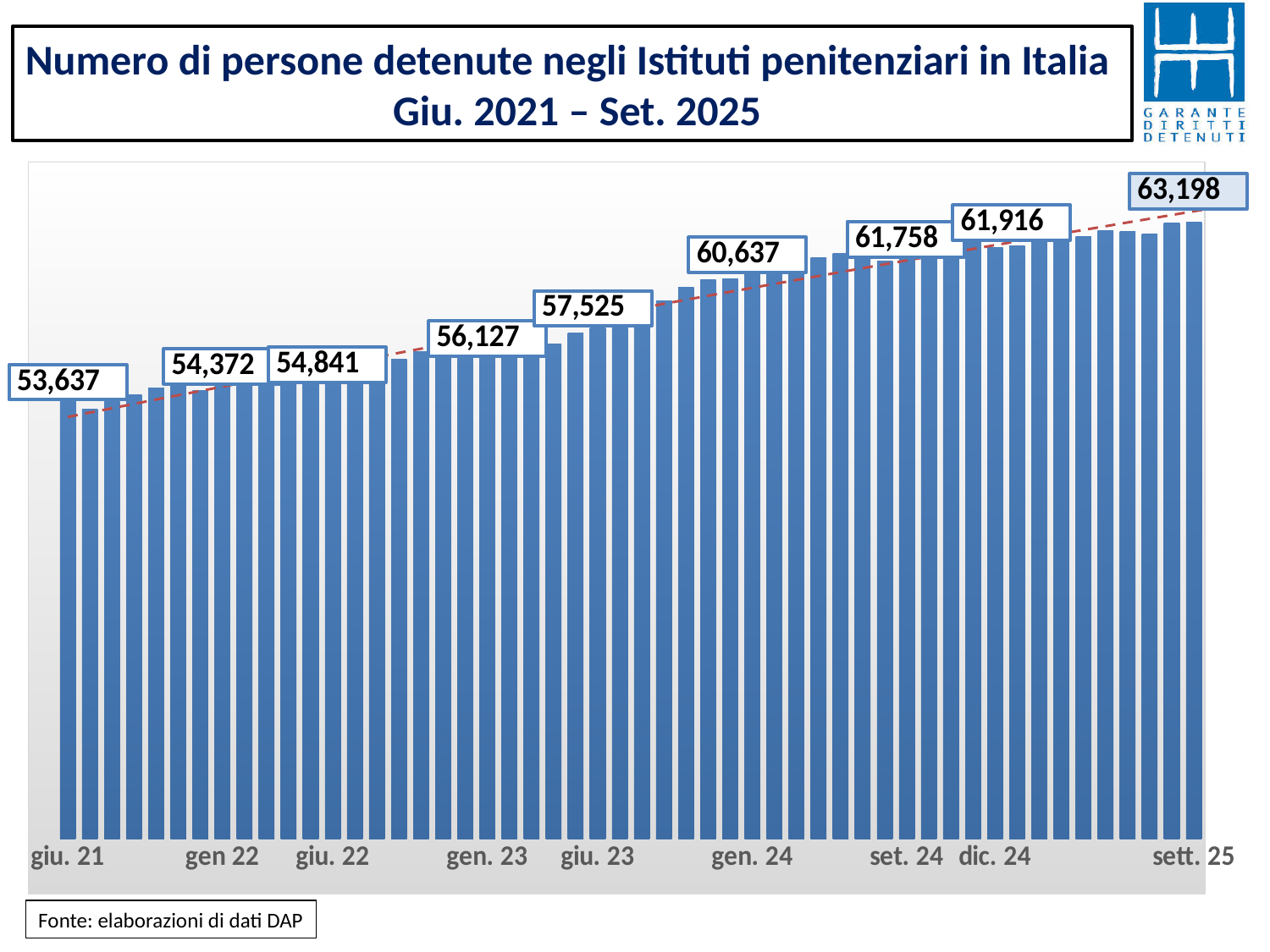
What is the difference between the labelled values for dic. 24 and set. 24? 158 Which is larger, the labelled value for gen. 24 or for giu. 23? gen. 24 Do the values rise or fall from giu. 21 to sett. 25? rise What source is cited below the chart? Fonte: elaborazioni di dati DAP Which labelled period has the lowest number of detained persons? giu. 21 What value is labelled for gen. 24? 60,637 What value is labelled for gen 22? 54,372 What kind of chart is shown on the slide? bar chart What value is labelled for giu. 21? 53,637 What is the difference between the labelled values for sett. 25 and giu. 21? 9,561 What value is labelled for sett. 25? 63,198 Which labelled period has the highest number of detained persons? sett. 25